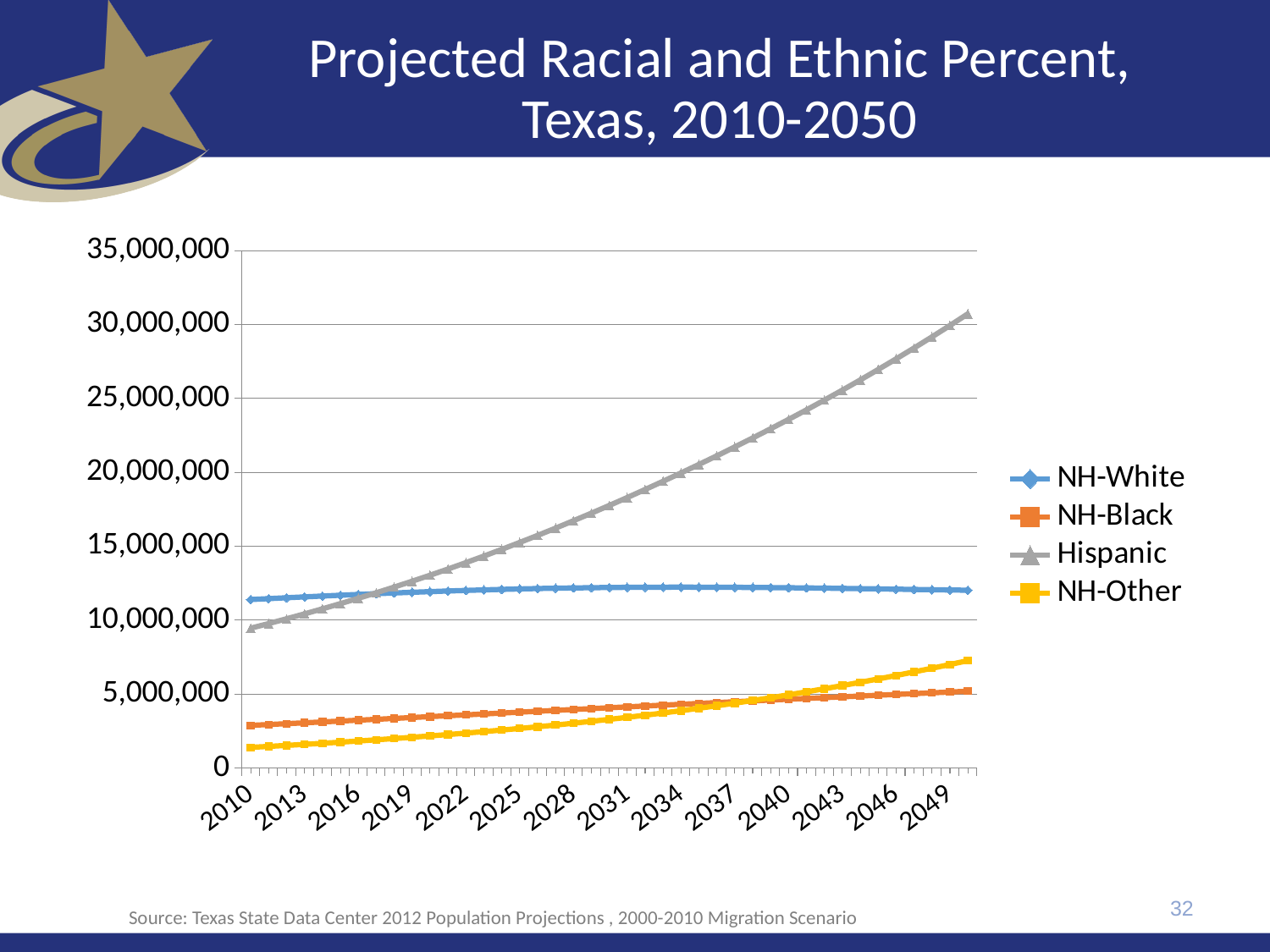
Which is larger in 2049, NH-Black or NH-Other? NH-Other Which series has the lowest value in 2010? NH-Other Is the value for Hispanic in 2010 greater or less than 10,000,000? less Does the Hispanic series rise or fall from 2010 to 2050? rise What is the title of the chart? Projected Racial and Ethnic Percent, Texas, 2010-2050 Which series has the highest value in 2049? Hispanic How many series does the legend list? 4 Is the value for NH-Other in 2049 greater or less than 5,000,000? greater Which is larger in 2010, Hispanic or NH-White? NH-White Does the NH-Other series rise or fall from 2010 to 2050? rise What kind of chart is shown on the slide? line chart Which series is plotted with the grey triangle markers? Hispanic